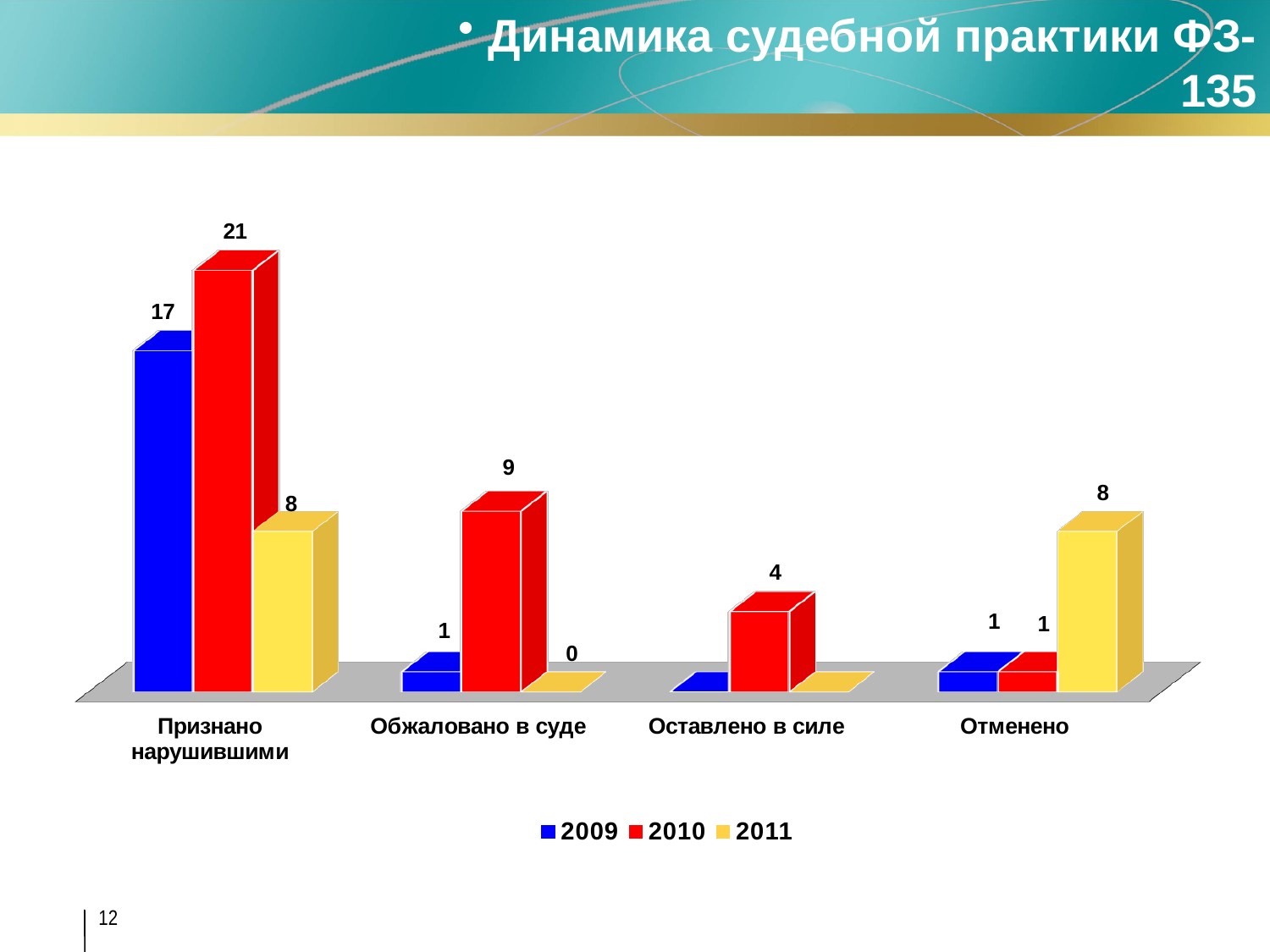
Which year has the lowest value in the "Признано нарушившими" category? 2011 What is the value for 2011 in the "Обжаловано в суде" category? 0 What is the value for 2010 in the "Признано нарушившими" category? 21 What is the value for 2011 in the "Отменено" category? 8 How many categories are shown on the x axis? 4 What kind of chart is shown on the slide? Bar chart Which is larger: the 2011 value for "Отменено" or the 2010 value for "Оставлено в силе"? 2011 value for "Отменено" What is the value for 2009 in the "Признано нарушившими" category? 17 Which colour represents the 2011 series in the legend? Yellow Which year has the highest value in the "Обжаловано в суде" category? 2010 How many series does the legend list? 3 What is the difference between the 2010 and 2009 values in the "Признано нарушившими" category? 4